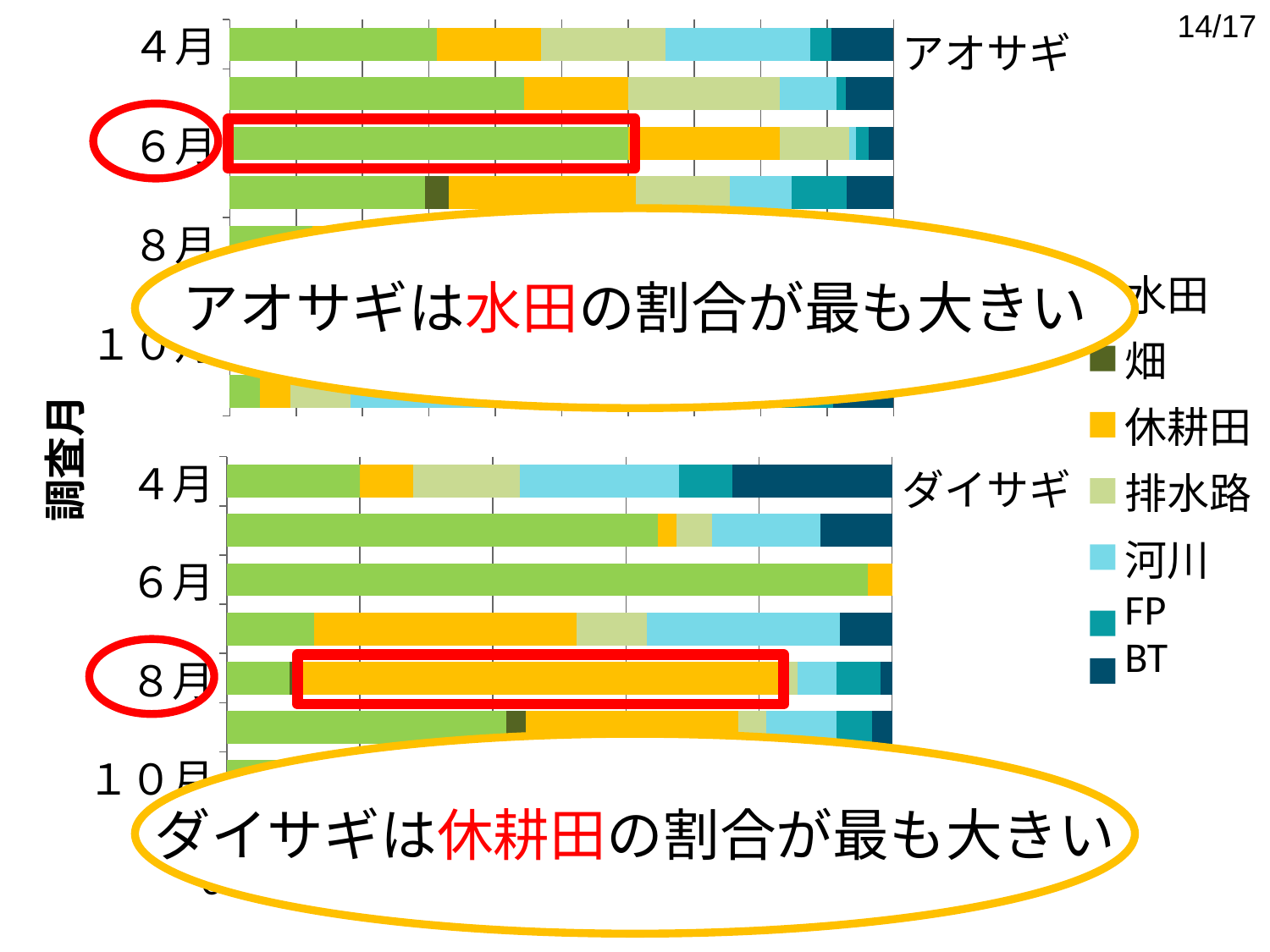
In the アオサギ chart's 6月 bar, which is smaller, the FP segment or the 休耕田 segment? FP In the ダイサギ chart's 8月 bar, which is larger, the 水田 segment or the 休耕田 segment? 休耕田 What are the legend entries shown on the slide? 水田, 畑, 休耕田, 排水路, 河川, FP, BT In the ダイサギ chart's 4月 bar, which is larger, the 水田 segment or the 休耕田 segment? 水田 In the ダイサギ chart, which category takes the largest share of the 6月 bar? 水田 In the ダイサギ chart, which category takes the largest share of the 8月 bar? 休耕田 In the アオサギ chart, which category takes the largest share of the 6月 bar? 水田 What kind of chart is used for the アオサギ data? bar chart How many series does the legend list? 7 What is the title of the vertical axis shared by the two charts? 調査月